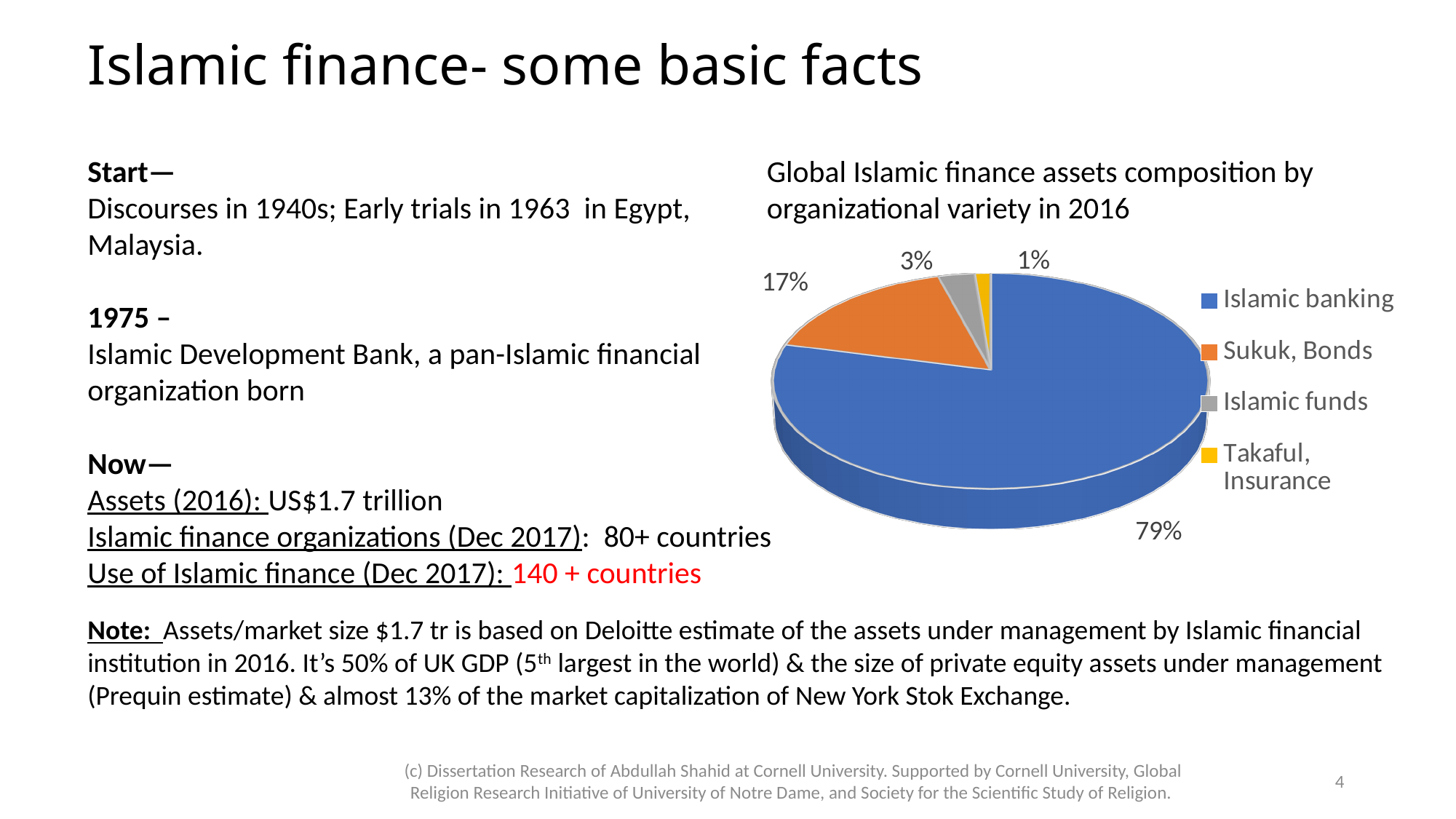
What share of the pie is Takaful, Insurance? 1% What kind of chart is shown on the slide? pie chart What is the title of the pie chart? Global Islamic finance assets composition by organizational variety in 2016 What colour is the Sukuk, Bonds slice in the pie chart? orange What share of global Islamic finance assets is Islamic banking? 79% How many categories does the pie chart show? 4 Which category has the smallest share of the pie? Takaful, Insurance What share of the pie is Islamic funds? 3% Which category has the largest share of the pie? Islamic banking Which is larger, the share for Islamic funds or the share for Takaful, Insurance? Islamic funds What is the difference in percentage points between Islamic banking and Sukuk, Bonds? 62